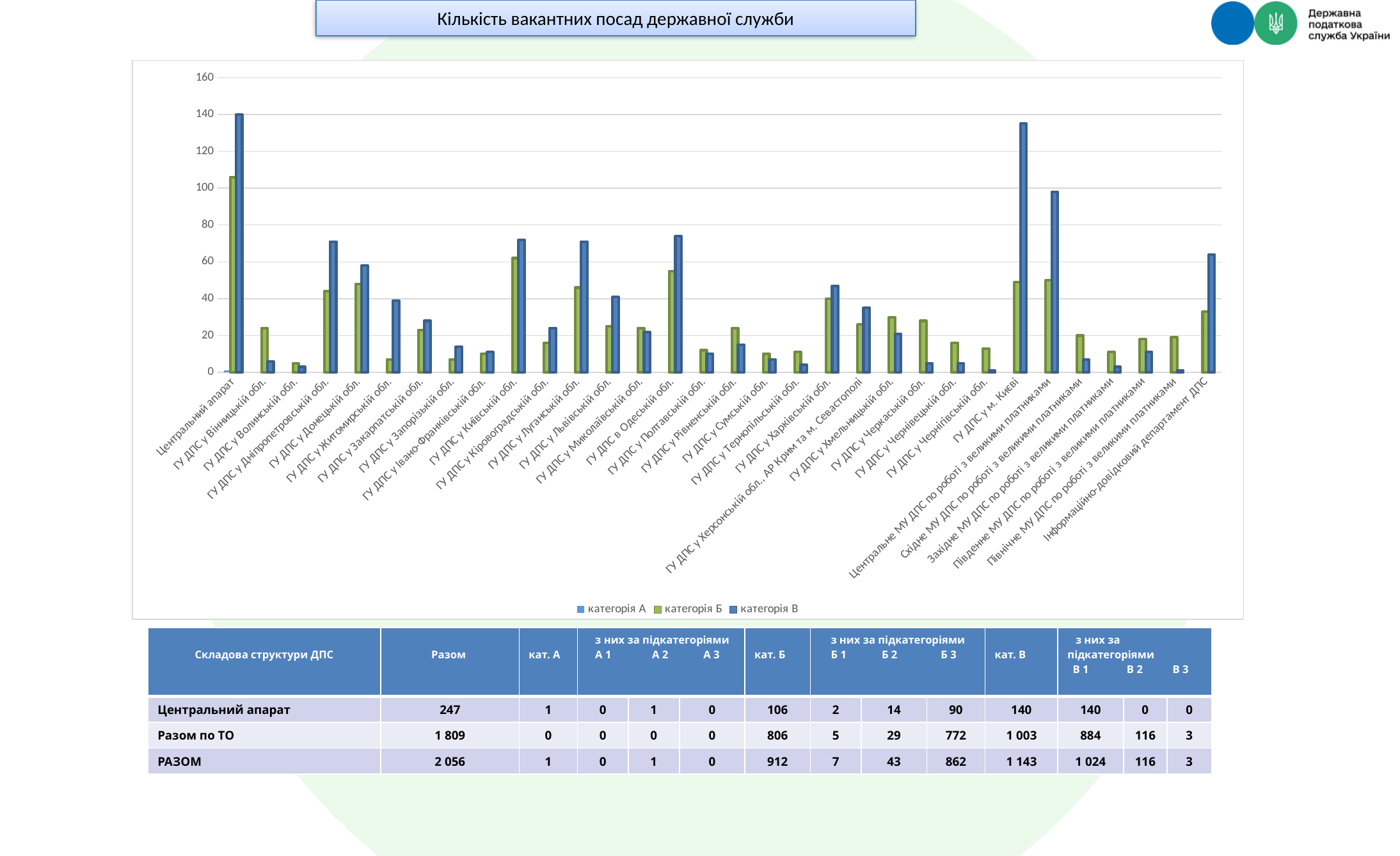
Is the value of категорія В for Східне МУ ДПС по роботі з великими платниками greater or less than 80? less Is the value of категорія В for ГУ ДПС в Одеській обл. greater or less than 60? greater Which category has the highest value for категорія В? Центральний апарат How many series does the chart legend list? 3 What is the title of the slide's chart? Кількість вакантних посад державної служби Which category has the highest value for категорія Б? Центральний апарат What kind of chart is shown on the slide? bar chart Which colour represents категорія Б in the chart? green Is the value of категорія Б for ГУ ДПС у Київській обл. greater or less than 40? greater What is the value of категорія В for Центральний апарат? 140 Which has the larger value for категорія В: ГУ ДПС у Дніпропетровській обл. or ГУ ДПС у Донецькій обл.? ГУ ДПС у Дніпропетровській обл.